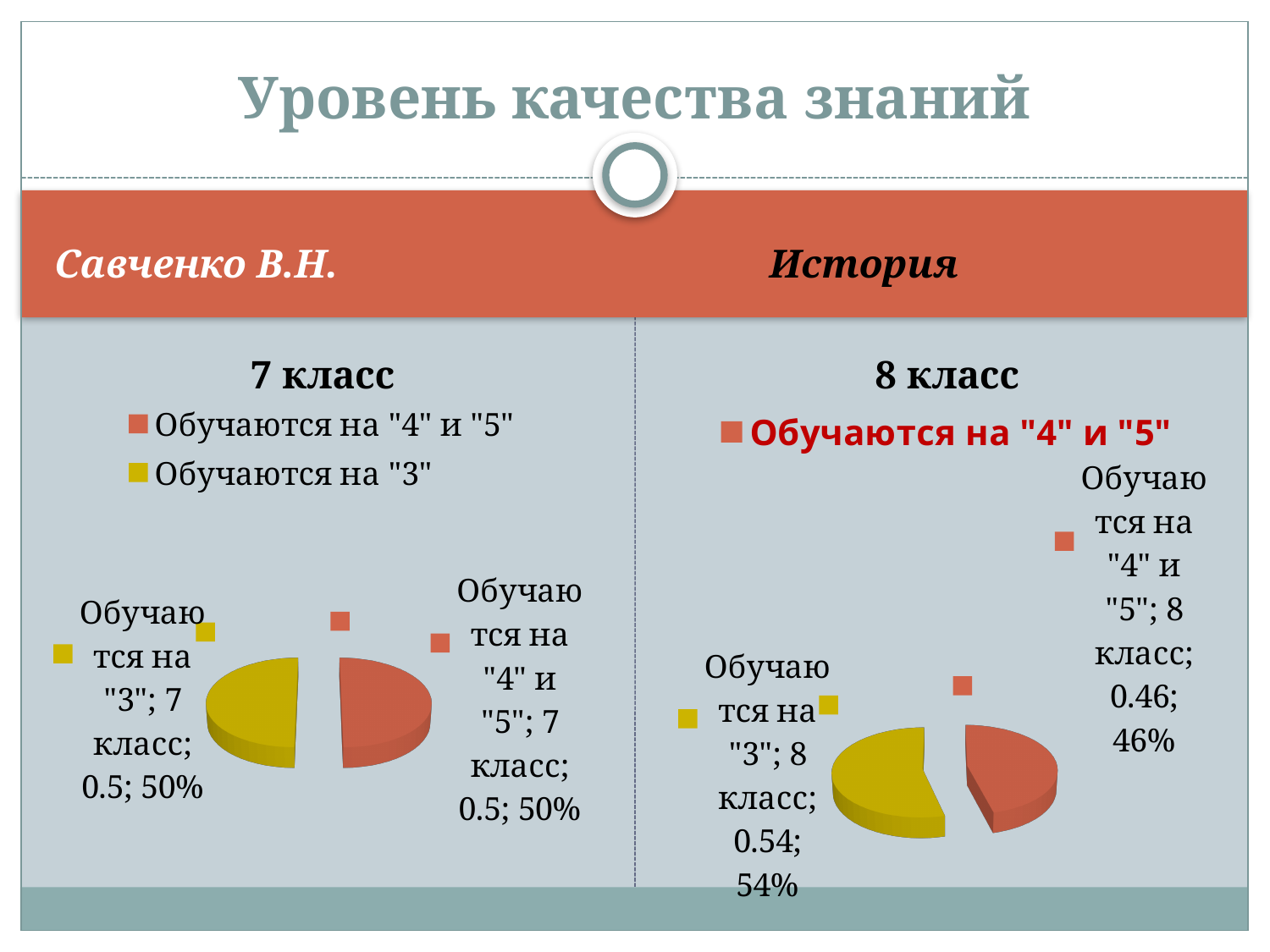
In the "7 класс" chart, what value is shown for Обучаются на "3"? 0.5 How many entries does the legend of the "7 класс" chart list? 2 What colour is the Обучаются на "3" slice in the "8 класс" chart? yellow What kind of chart is the "7 класс" chart on the left? pie chart In the "7 класс" chart, what share of the pie is labelled Обучаются на "4" и "5"? 50% In the "8 класс" chart, what value is shown for Обучаются на "4" и "5"? 0.46 In the "8 класс" chart, what share of the pie is labelled Обучаются на "3"? 54% In the "8 класс" chart, which slice is larger: Обучаются на "3" or Обучаются на "4" и "5"? Обучаются на "3" In the "8 класс" chart, what is the difference in percentage points between the Обучаются на "3" slice and the Обучаются на "4" и "5" slice? 8 How many slices does the "7 класс" pie chart have? 2 What kind of chart is the "8 класс" chart on the right? pie chart In the "8 класс" chart, what share of the pie is labelled Обучаются на "4" и "5"? 46%